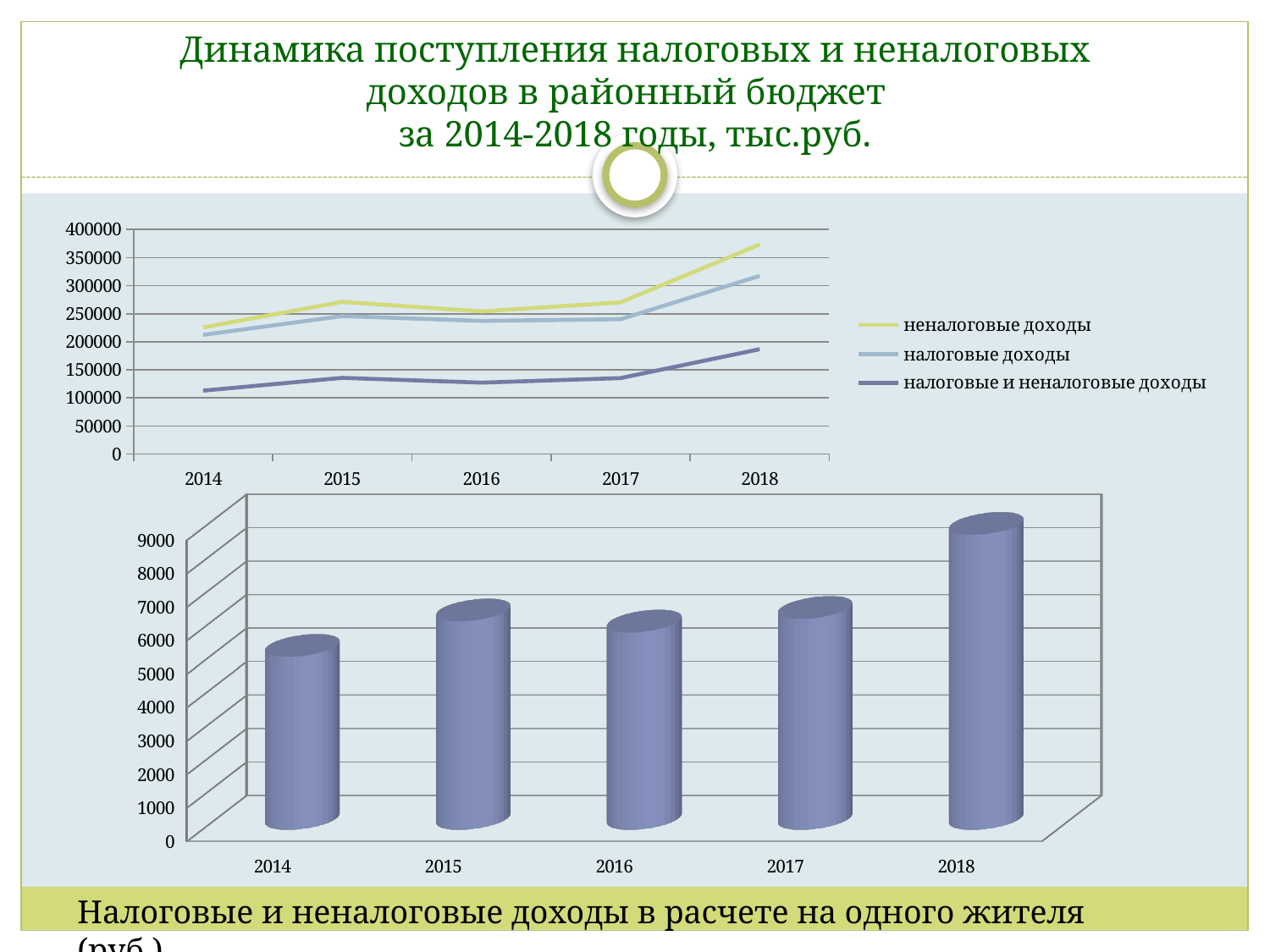
What kind of chart is the top chart on the slide? line chart In the bottom bar chart, is the value for 2014 greater or less than 6000? less In the top line chart, does the series налоговые доходы rise or fall from 2017 to 2018? rise What kind of chart is the bottom chart on the slide? bar chart In the bottom bar chart, which year has the lowest value? 2014 In the top line chart, is the value of налоговые и неналоговые доходы in 2014 greater or less than 150000? less In the bottom bar chart, how many years are shown on the x axis? 5 In the top line chart, how many series does the legend list? 3 In the bottom bar chart, which year has the highest value? 2018 In the bottom bar chart, is the value for 2018 greater or less than 8000? greater